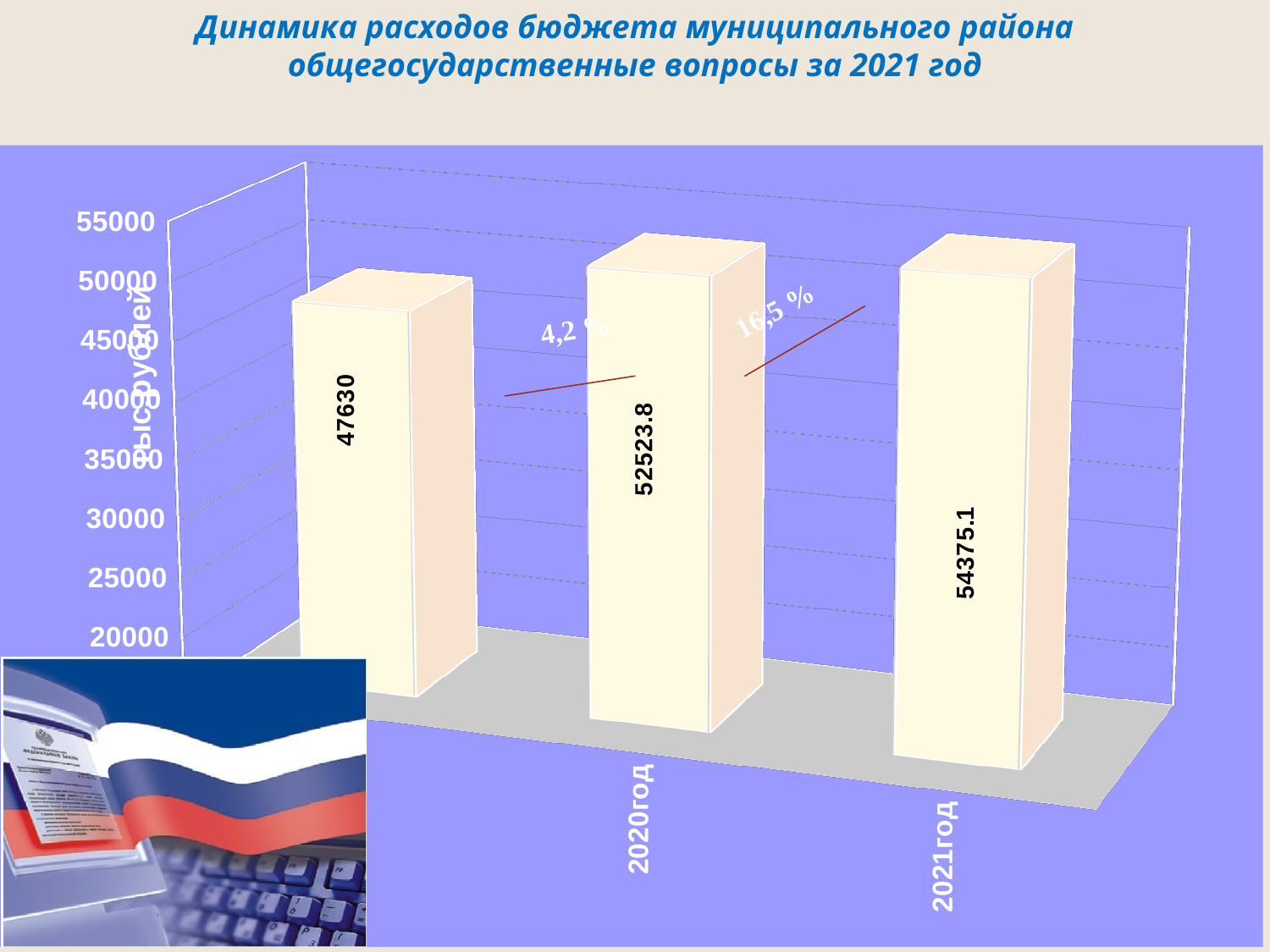
What is the value for 2020год? 52523.8 Is the value for 2020год greater or less than 50000? greater What percentage is annotated between the 2020год bar and the 2021год bar? 16,5 % What is the value printed on the leftmost bar? 47630 What is the difference between the values for 2021год and 2020год? 1851.3 How many bars are plotted on the chart? 3 Which is larger, the value for 2020год or the value for 2021год? 2021год Do the values rise or fall from left to right along the x axis? rise Is the value for 2021год greater or less than 55000? less What kind of chart is shown on the slide? bar chart What is the value for 2021год? 54375.1 Which year has the highest value on the chart? 2021год